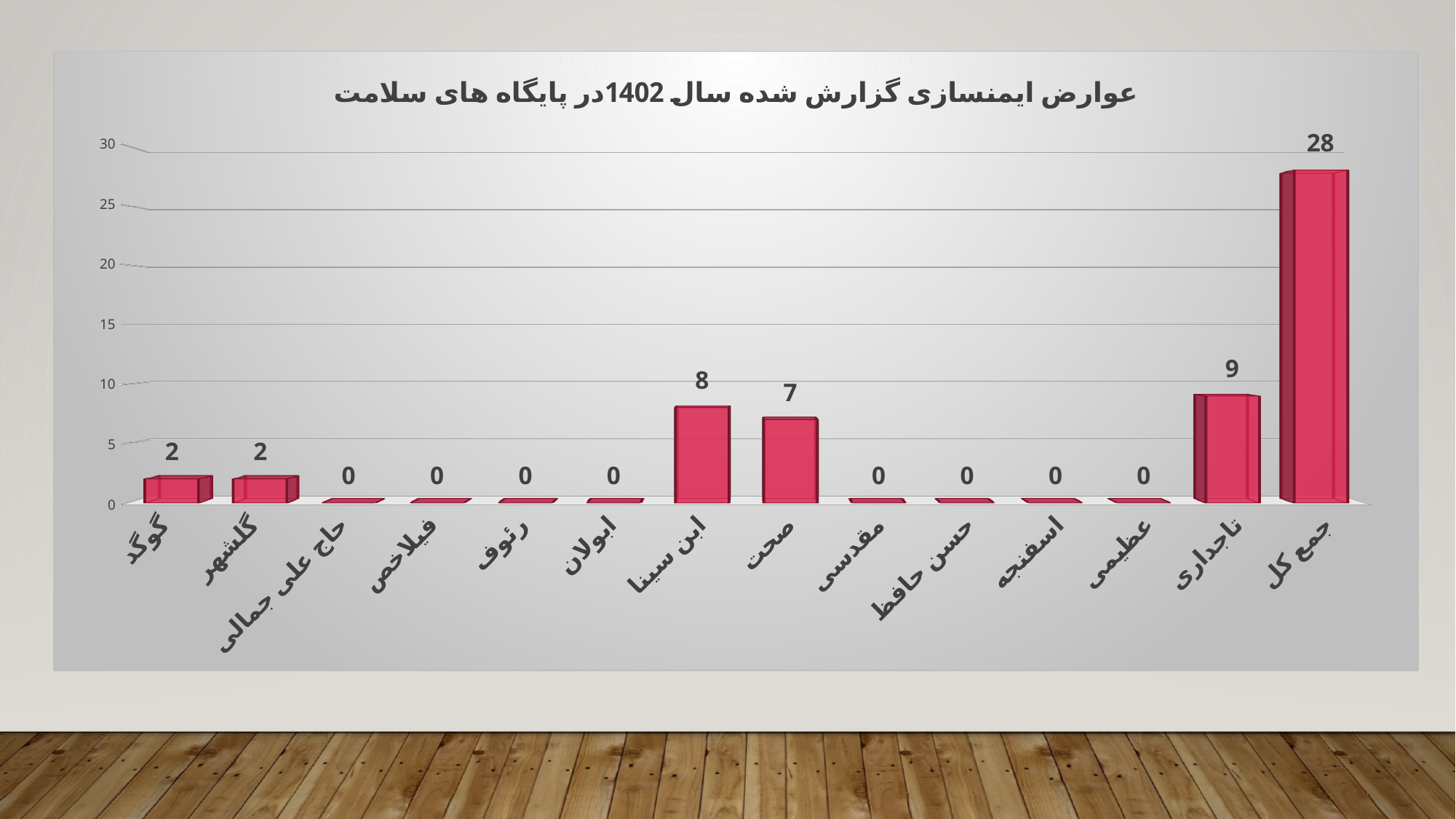
What is the value for گلشهر? 2 Which is larger, the value for ابن سینا or the value for صحت? ابن سینا What is the value for جمع کل? 28 What kind of chart is shown on the slide? Bar chart What is the value for صحت? 7 What is the title of the chart? عوارض ایمنسازی گزارش شده سال 1402در پایگاه های سلامت Which category has the highest value? جمع کل How many categories are shown on the x axis? 14 What is the value for تاجداری? 9 What is the difference between the values for تاجداری and ابن سینا? 1 Excluding جمع کل, which category has the highest value? تاجداری What is the value for ابن سینا? 8